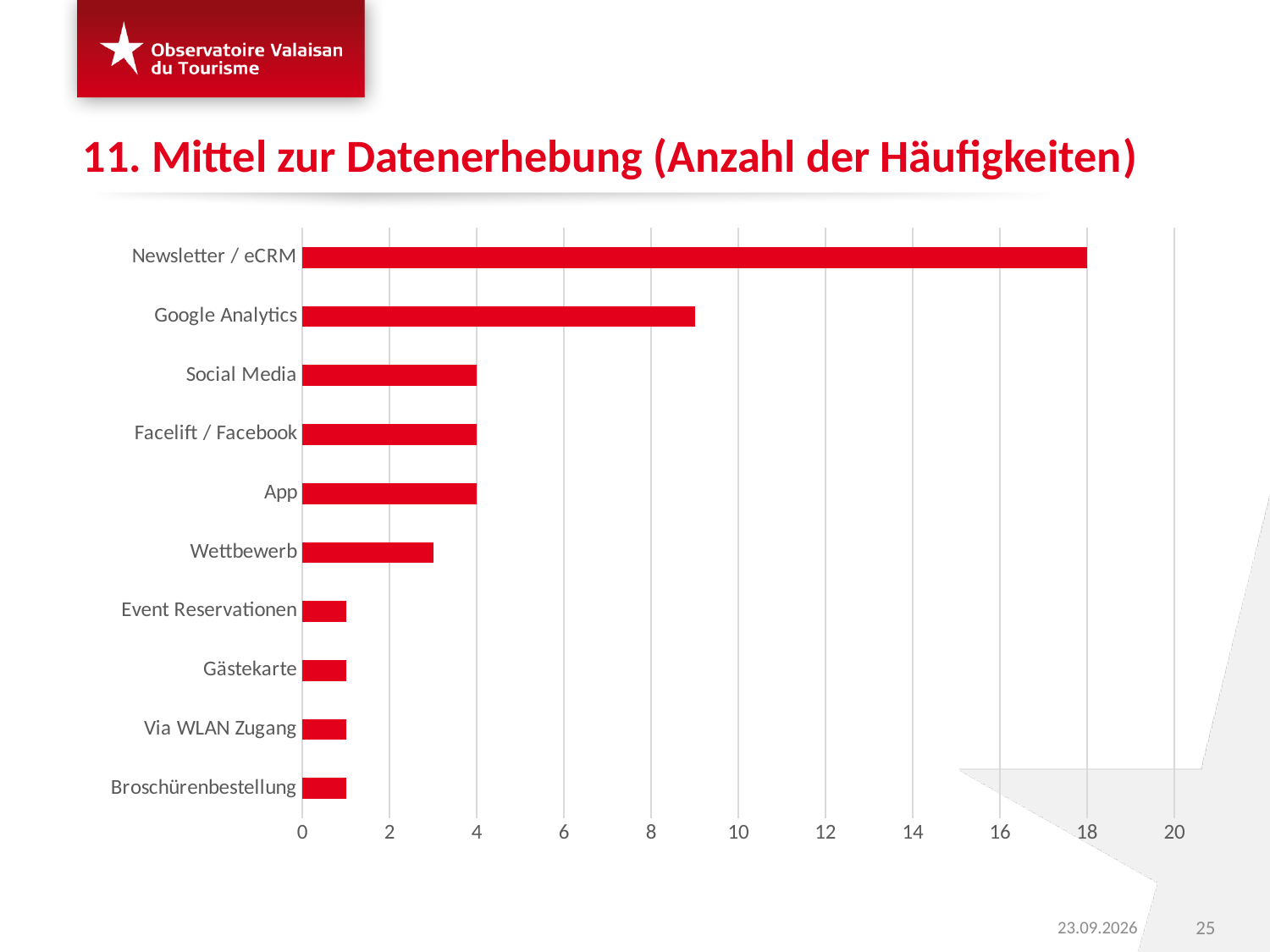
Is the value for Google Analytics greater or less than 8? greater What is the title of the chart on the slide? 11. Mittel zur Datenerhebung (Anzahl der Häufigkeiten) Which category has the highest value? Newsletter / eCRM What is the value for Social Media? 4 What is the difference between the values for Newsletter / eCRM and Social Media? 14 Which is larger, the value for Google Analytics or the value for Wettbewerb? Google Analytics Is the value for Wettbewerb greater or less than 4? less What type of chart is shown on the slide? bar chart What is the value for App? 4 What is the value for Facelift / Facebook? 4 How many categories are plotted in the chart? 10 What is the value for Newsletter / eCRM? 18